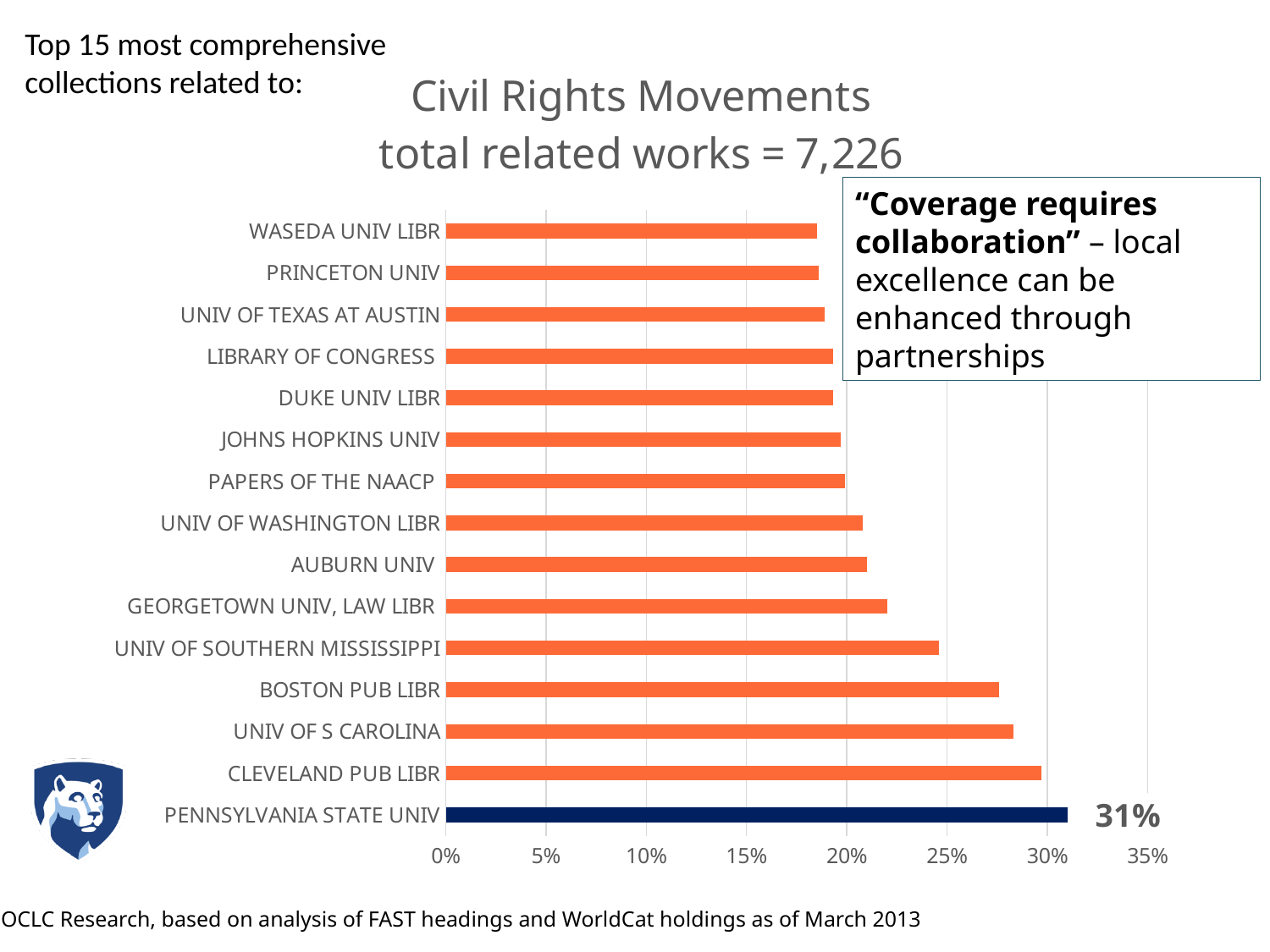
Is the value for Boston Pub Libr greater or less than 25%? greater What kind of chart is shown on the slide? Bar chart Which institution's bar is shown in a different colour (dark blue) from the others? Pennsylvania State Univ How many institutions are listed in the chart? 15 Is the value for Univ of S Carolina greater or less than 30%? less Which has the larger value, Univ of S Carolina or Georgetown Univ, Law Libr? Univ of S Carolina Is the value for Georgetown Univ, Law Libr greater or less than 20%? greater Which has the larger value, Auburn Univ or Boston Pub Libr? Boston Pub Libr According to the chart title, what is the total number of related works? 7,226 Which institution has the highest value in the chart? Pennsylvania State Univ What is the value shown for Pennsylvania State Univ? 31%